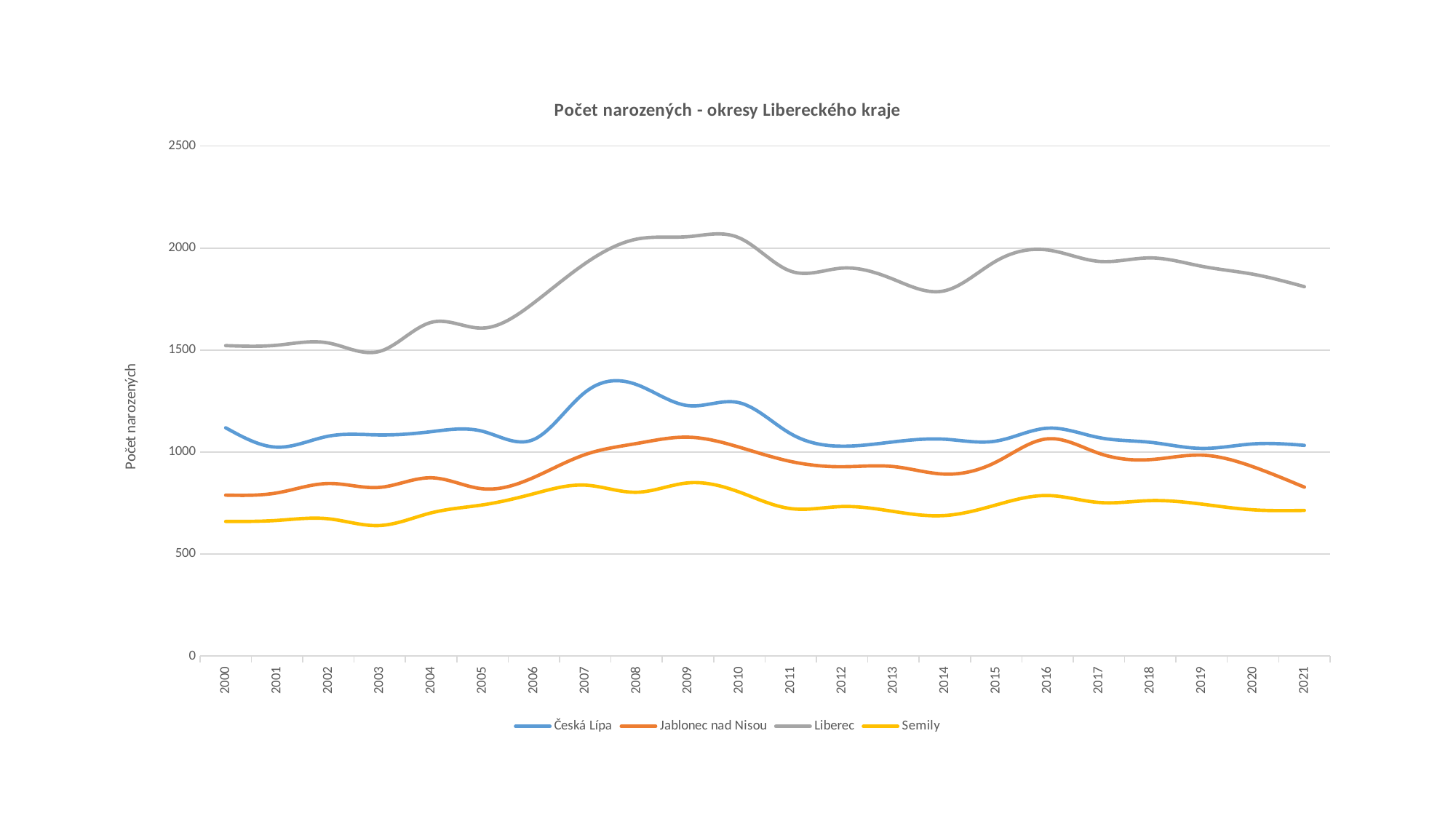
How many series does the legend list? 4 Is the value for Česká Lípa in 2008 greater or less than 1500? less In 2005, which is larger: the value for Jablonec nad Nisou or the value for Semily? Jablonec nad Nisou What kind of chart is shown on the slide? line chart What is the title of the chart? Počet narozených - okresy Libereckého kraje Is the value for Semily in 2009 greater or less than 1000? less Is the value for Jablonec nad Nisou in 2021 greater or less than 1000? less How many years are plotted along the x axis? 22 Which district has the lowest number of births across the whole period? Semily Which district has the highest number of births across the whole period? Liberec Does the Liberec line rise or fall between 2000 and 2008? rise